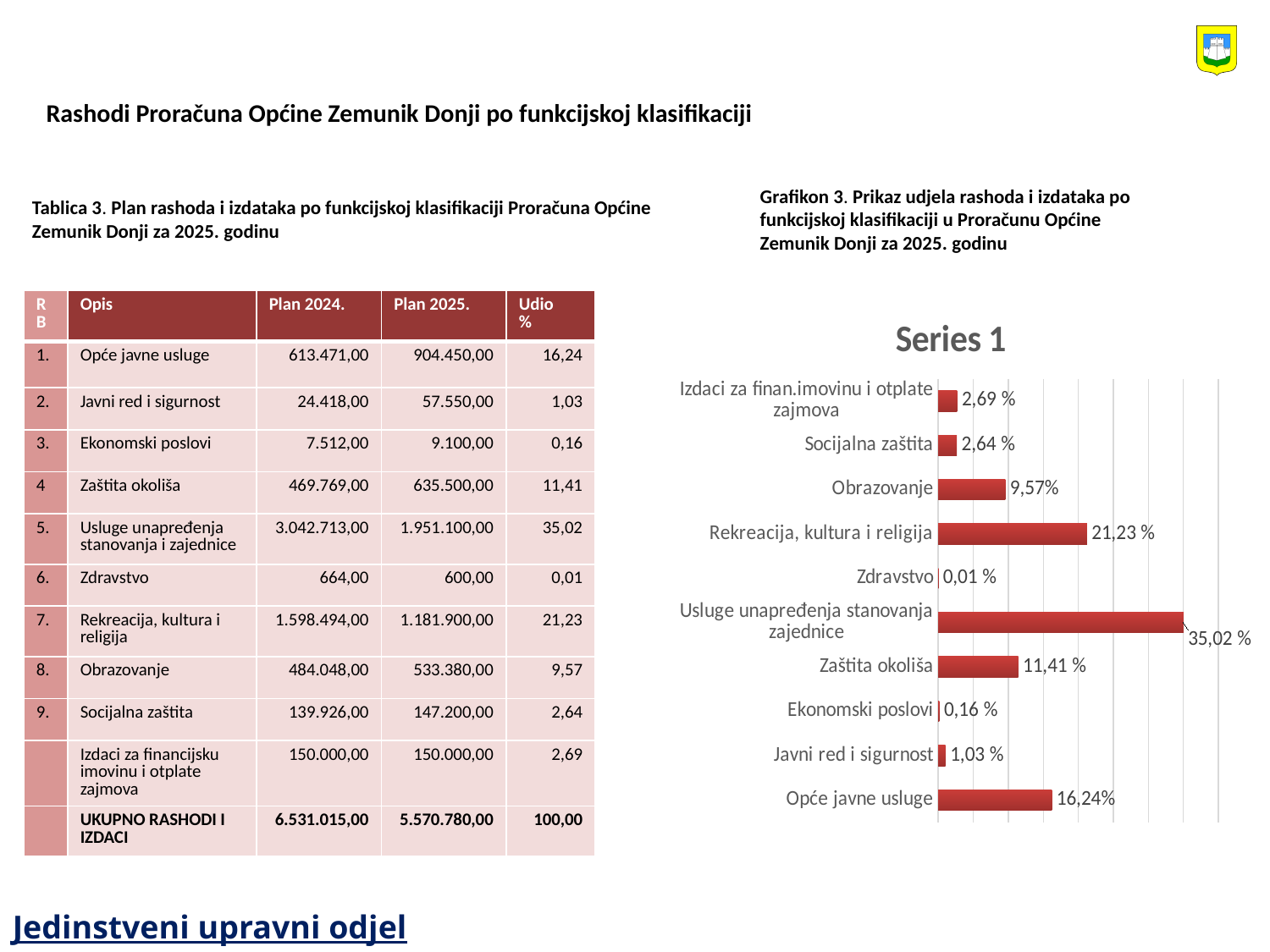
Which is larger in the chart: Zaštita okoliša or Obrazovanje? Zaštita okoliša What is the value shown for Obrazovanje in the chart? 9,57% What is the title shown above the chart? Series 1 What is the value shown for Zaštita okoliša in the chart? 11,41 % How many categories are plotted in the chart? 10 What is the difference between the values for Usluge unapređenja stanovanja zajednice and Opće javne usluge? 18,78 % What kind of chart is shown on the slide? Bar chart What is the value shown for Rekreacija, kultura i religija in the chart? 21,23 % Which category has the lowest value in the chart? Zdravstvo Which category has the highest value in the chart? Usluge unapređenja stanovanja zajednice What is the value shown for Javni red i sigurnost in the chart? 1,03 % What is the difference between the values for Socijalna zaštita and Izdaci za finan.imovinu i otplate zajmova? 0,05 %